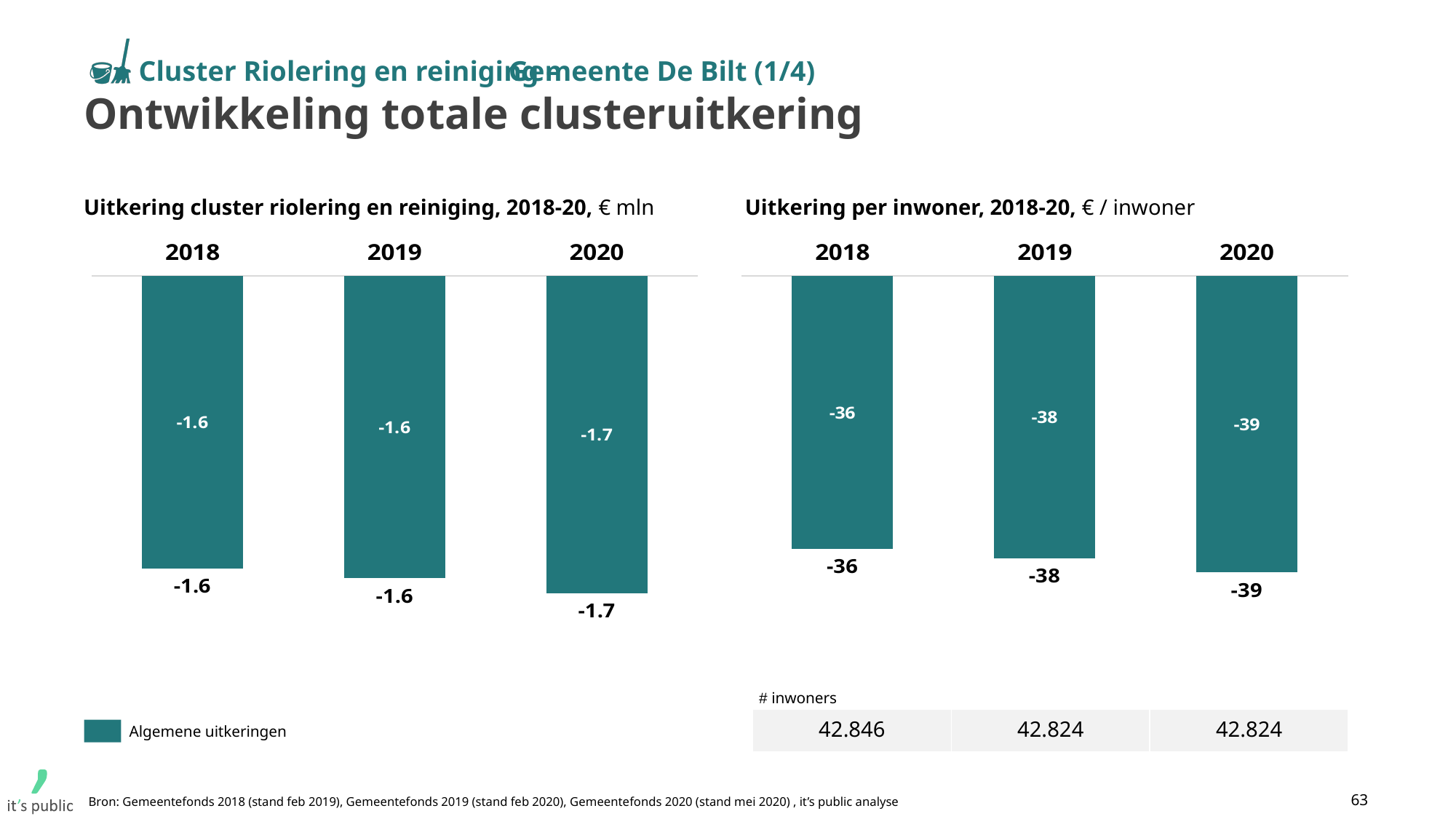
In the chart 'Uitkering cluster riolering en reiniging, 2018-20', which year has the lowest value? 2020 In the chart 'Uitkering cluster riolering en reiniging, 2018-20', what is the value for 2020? -1.7 In the chart 'Uitkering per inwoner, 2018-20', which year has the highest value? 2018 In the chart 'Uitkering per inwoner, 2018-20', which year has the lowest value? 2020 In the chart 'Uitkering per inwoner, 2018-20', what is the value for 2020? -39 In the chart 'Uitkering per inwoner, 2018-20', what is the value for 2019? -38 In the chart 'Uitkering per inwoner, 2018-20', do the values rise or fall from 2018 to 2020? fall In the chart 'Uitkering per inwoner, 2018-20', what is the difference between the values for 2018 and 2020? 3 How many years are shown in the chart 'Uitkering cluster riolering en reiniging, 2018-20'? 3 What is the legend entry shown below the left chart? Algemene uitkeringen In the chart 'Uitkering cluster riolering en reiniging, 2018-20', what is the value for 2018? -1.6 What kind of chart is 'Uitkering per inwoner, 2018-20'? bar chart